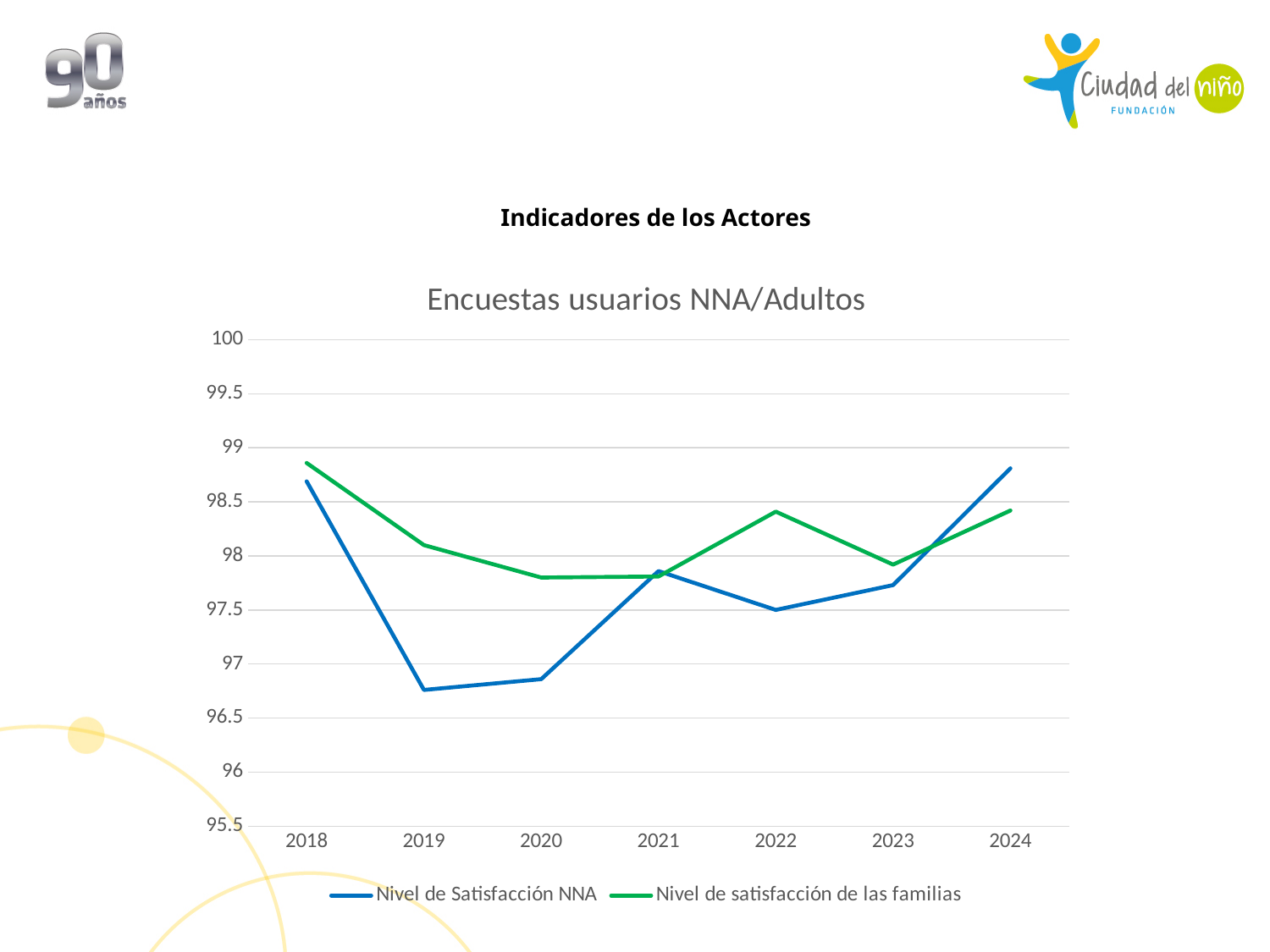
What kind of chart is shown on the slide? line chart In 2019, which series has the larger value, Nivel de Satisfacción NNA or Nivel de satisfacción de las familias? Nivel de satisfacción de las familias How many series does the legend list? 2 Does Nivel de Satisfacción NNA rise or fall from 2018 to 2019? fall In 2024, which series has the larger value, Nivel de Satisfacción NNA or Nivel de satisfacción de las familias? Nivel de Satisfacción NNA What is the title of the chart? Encuestas usuarios NNA/Adultos How many years are shown on the x axis? 7 Is the value for Nivel de Satisfacción NNA in 2019 greater or less than 97? less Is the value for Nivel de satisfacción de las familias in 2022 greater or less than 98? greater Is the value for Nivel de Satisfacción NNA in 2024 greater or less than 98.5? greater In which year is Nivel de satisfacción de las familias highest? 2018 Which series is drawn in green? Nivel de satisfacción de las familias